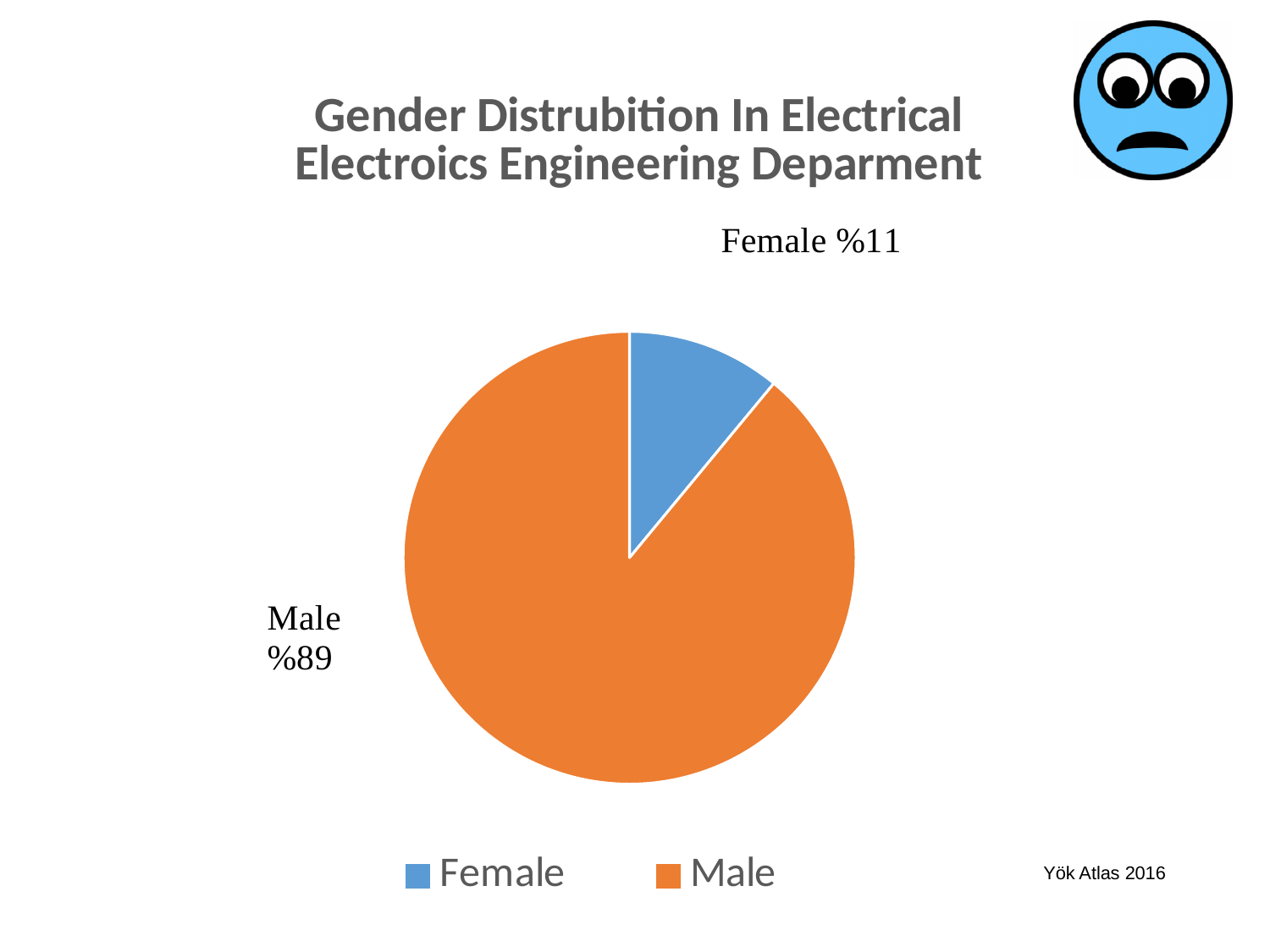
What is the difference between the Male and Female percentages? 78 What share of the pie does the Female slice represent? %11 Which category has the largest slice of the pie? Male What is the value shown for Female? %11 Which category has the smallest slice of the pie? Female What is the value shown for Male? %89 What colour is the Male slice? orange What kind of chart is shown on the slide? pie chart Which is larger, the share for Male or the share for Female? Male How many slices does the pie chart have? 2 What is the title of the chart? Gender Distrubition In Electrical Electroics Engineering Deparment How many entries does the legend list? 2